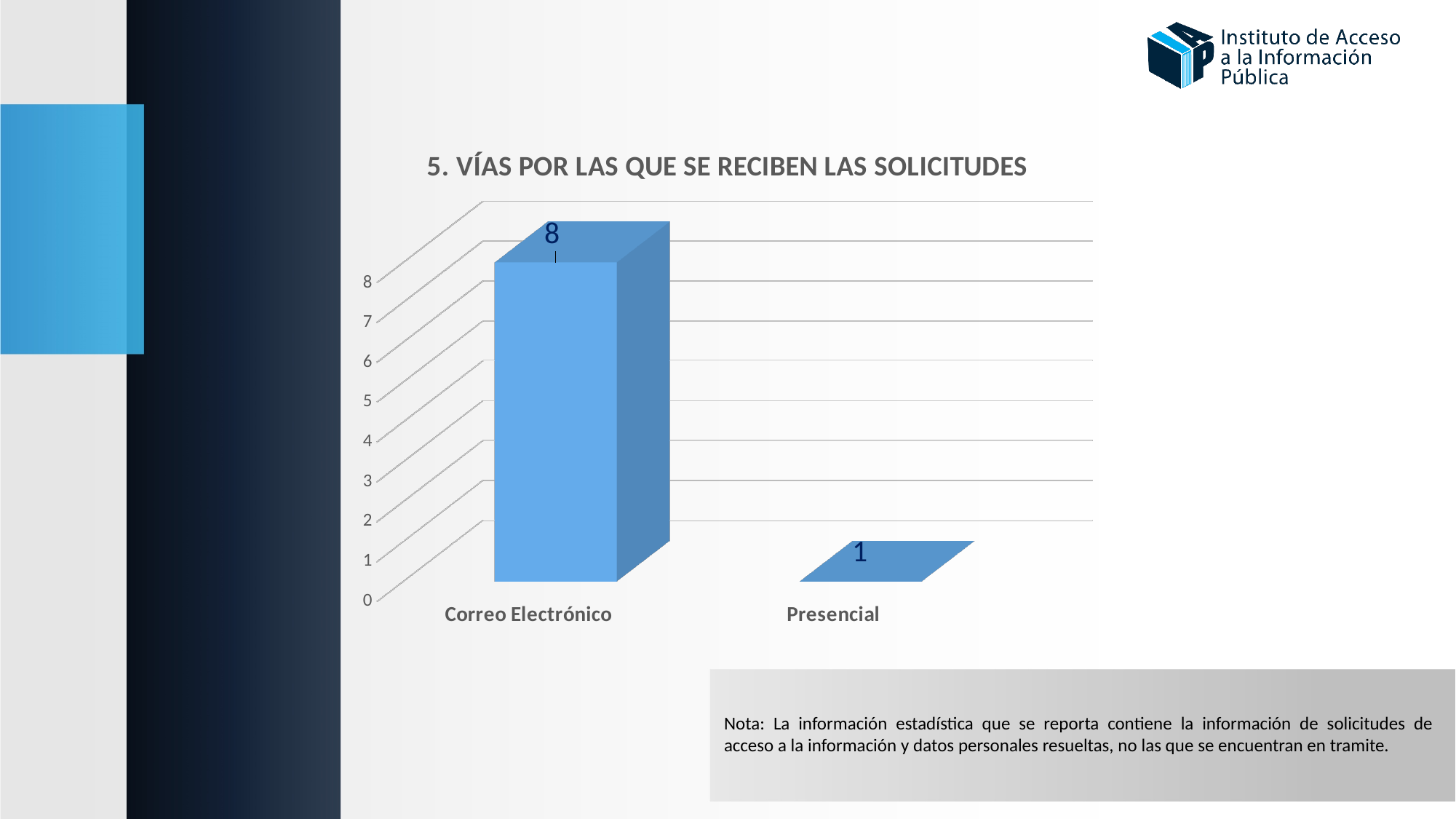
What is the difference between the values for Correo Electrónico and Presencial? 7 What is the highest value shown on the vertical axis? 8 What kind of chart is shown on the slide? bar chart Is the value for Presencial greater or less than 4? less What is the value for Correo Electrónico? 8 What is the value for Presencial? 1 Which is larger, the value for Correo Electrónico or the value for Presencial? Correo Electrónico Which category has the highest value? Correo Electrónico What is the title of the chart? 5. VÍAS POR LAS QUE SE RECIBEN LAS SOLICITUDES Is the value for Correo Electrónico greater or less than 5? greater How many categories are shown on the x axis? 2 Which category has the lowest value? Presencial